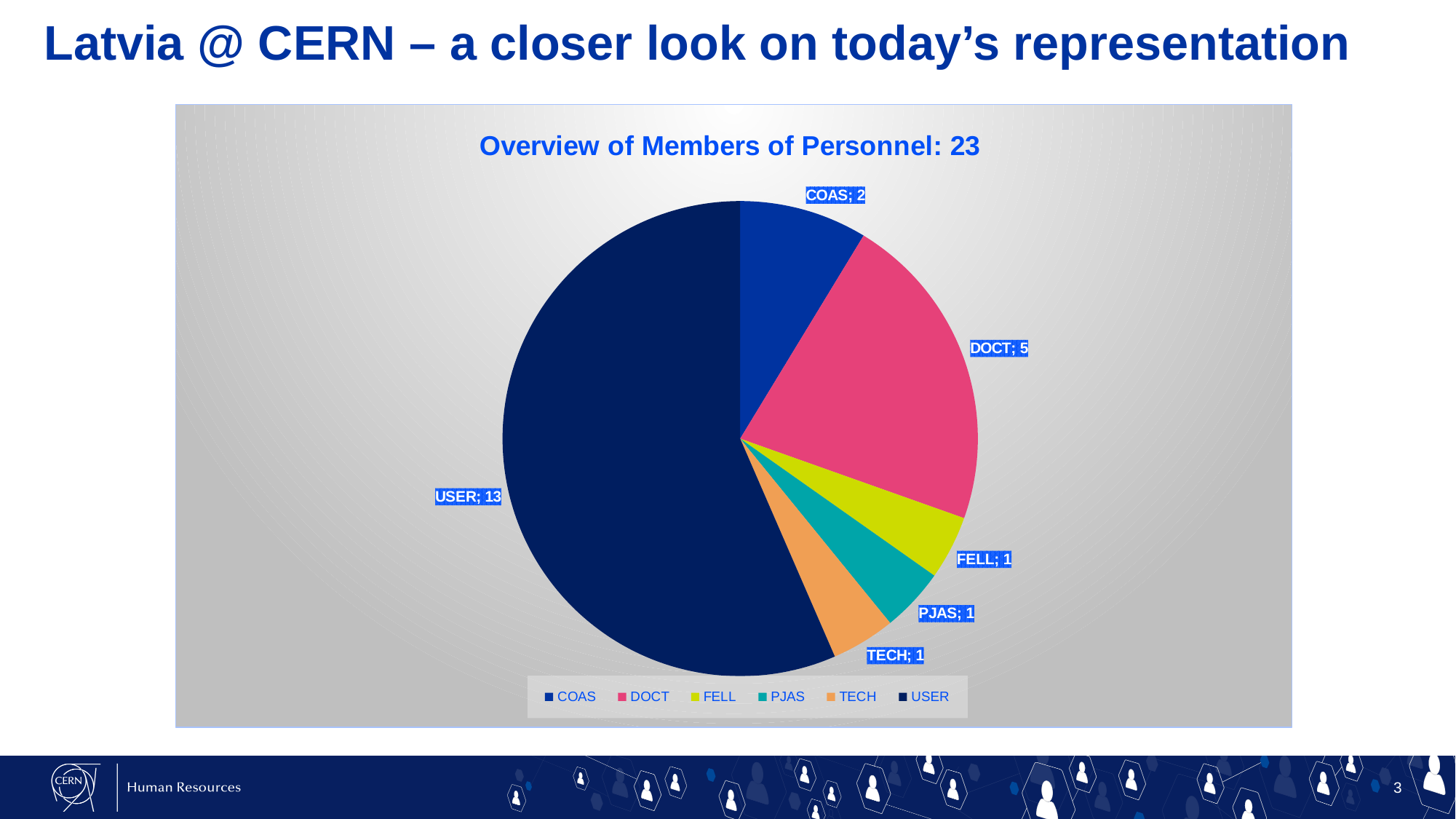
What is the value for DOCT? 5 What share of the total does the DOCT slice represent? 5 of 23 What is the value for USER? 13 How many entries does the legend list? 6 What kind of chart is shown on the slide? pie chart What is the total number of members of personnel shown in the chart title? 23 What is the difference between the values for USER and DOCT? 8 What is the title of the chart? Overview of Members of Personnel: 23 What is the value for COAS? 2 How many categories does the pie chart show? 6 Which category has the largest slice? USER Which is larger, the value for DOCT or the value for COAS? DOCT